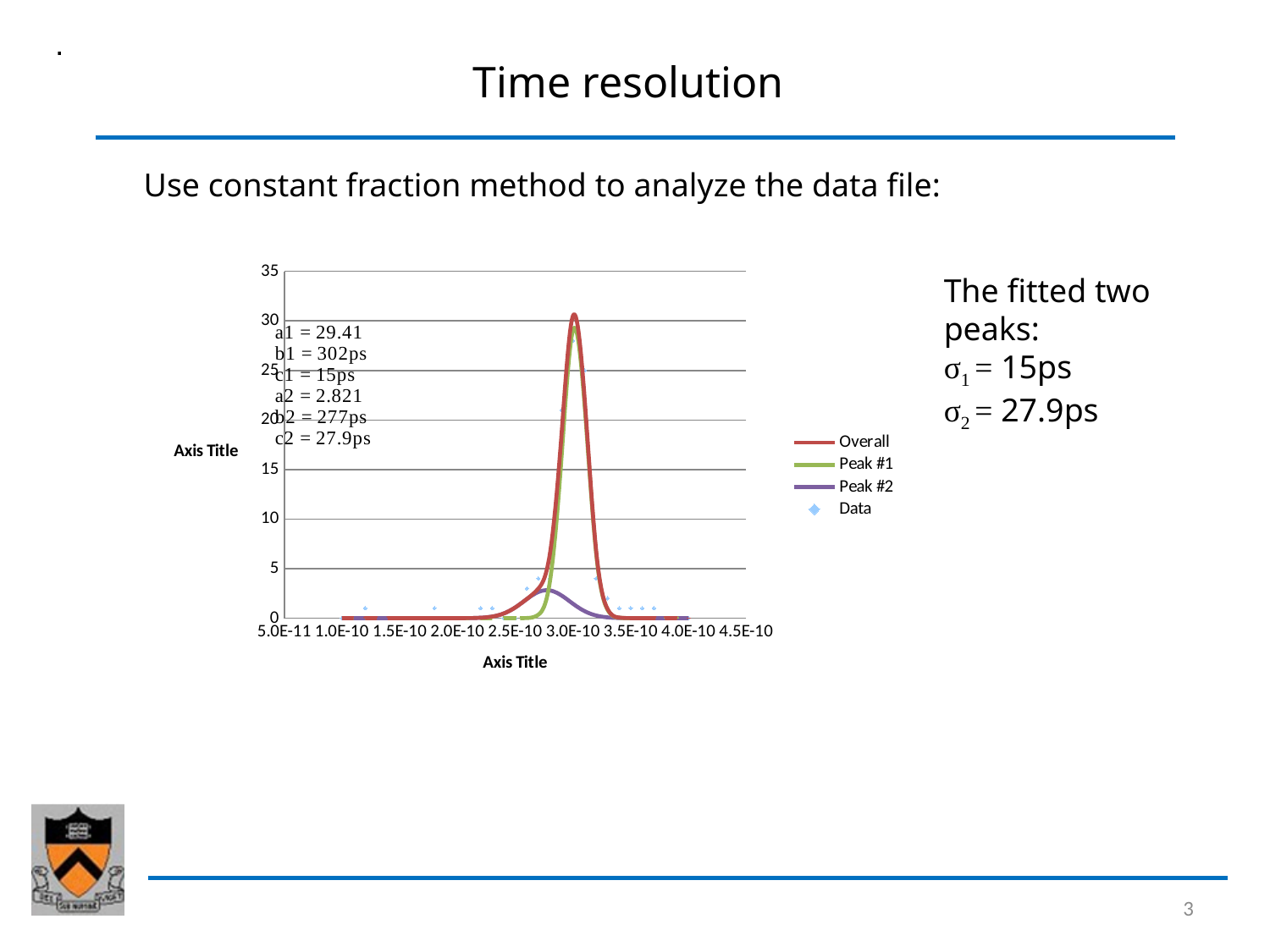
What is the highest tick value shown on the chart's vertical axis? 35 How many tick labels are shown on the chart's horizontal axis? 9 Is the maximum value of the Overall curve greater or less than 25? greater How many series does the chart legend list? 4 Which of the three fitted curves (Overall, Peak #1, Peak #2) reaches the lowest maximum value? Peak #2 What are the entries in the chart legend? Overall, Peak #1, Peak #2, Data Is the value of the Overall curve at 4.0E-10 greater or less than 5? less Is the maximum value of the Peak #1 curve greater or less than 20? greater Which fitted curve has the lower maximum, Peak #1 or Peak #2? Peak #2 What kind of chart is shown on the slide? line chart